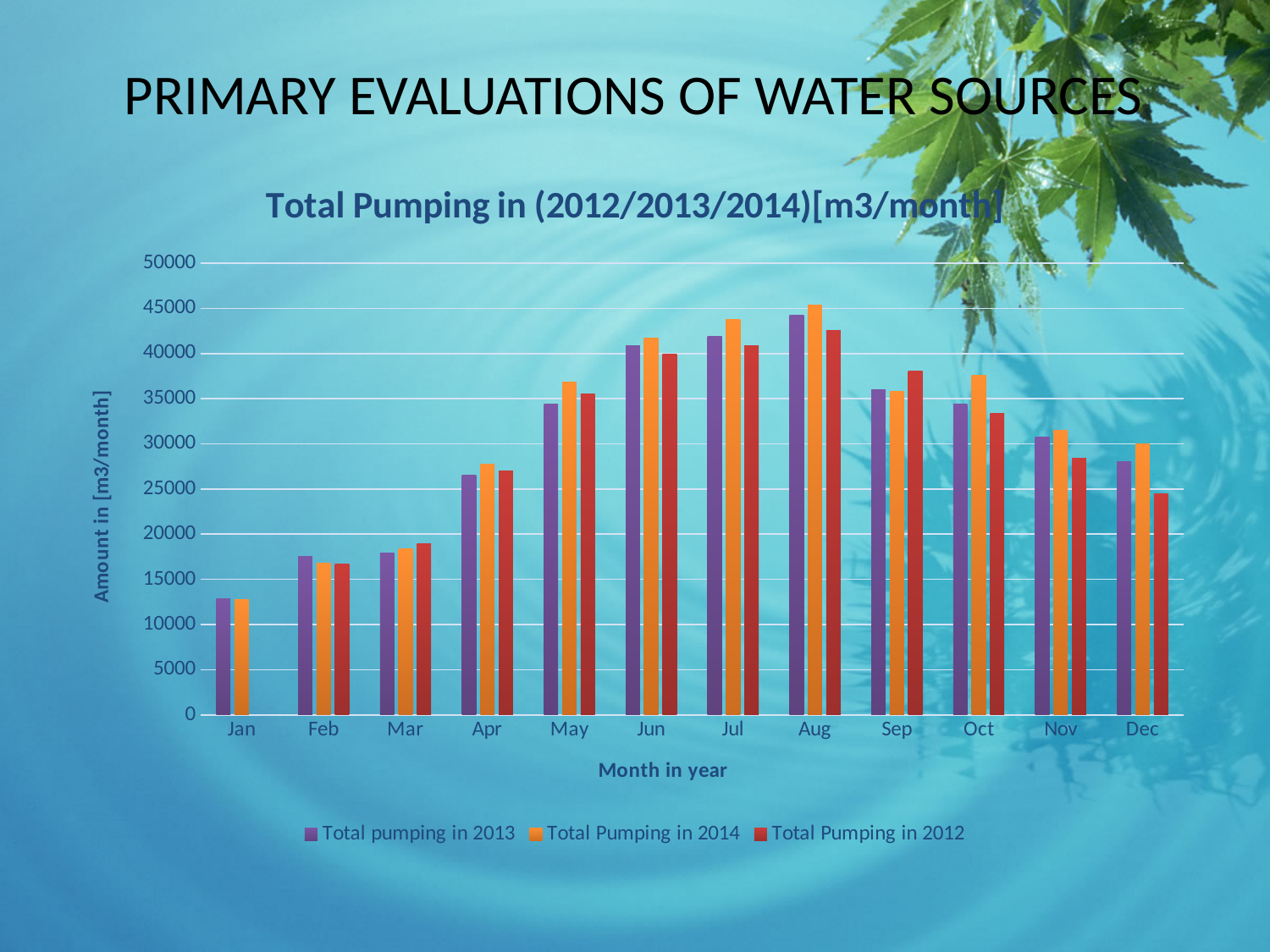
In which month is Total Pumping in 2014 highest? Aug What is the title of the chart? Total Pumping in (2012/2013/2014)[m3/month] In which month is Total pumping in 2013 lowest? Jan In Dec, which is larger: Total Pumping in 2014 or Total Pumping in 2012? Total Pumping in 2014 Is the value for Total pumping in 2013 in Jan greater or less than 15000? less Do the values for Total pumping in 2013 rise or fall from Jan to Aug? rise How many months are shown on the x axis? 12 Is the value for Total Pumping in 2014 in Oct greater or less than 35000? greater Is the value for Total pumping in 2013 in Aug greater or less than 40000? greater How many series does the legend list? 3 What kind of chart is shown on the slide? bar chart